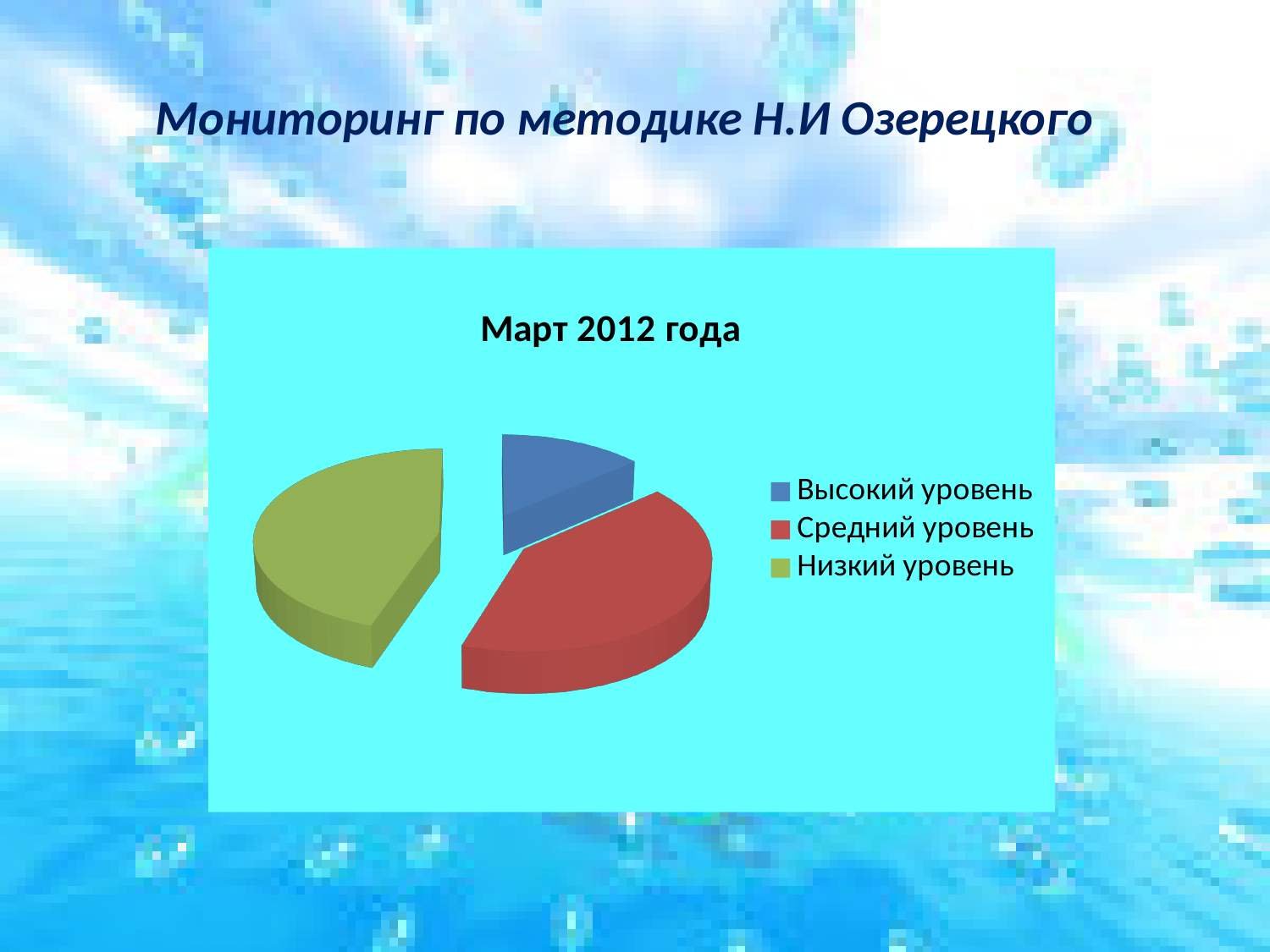
Which category has the smallest slice of the pie? Высокий уровень What kind of chart is shown on the slide? pie chart How many entries does the legend list? 3 What is the title of the chart? Март 2012 года Which slice is larger, Высокий уровень or Средний уровень? Средний уровень What colour is the slice for Низкий уровень? yellow-green Which slice is larger, Высокий уровень or Низкий уровень? Низкий уровень How many slices does the pie chart have? 3